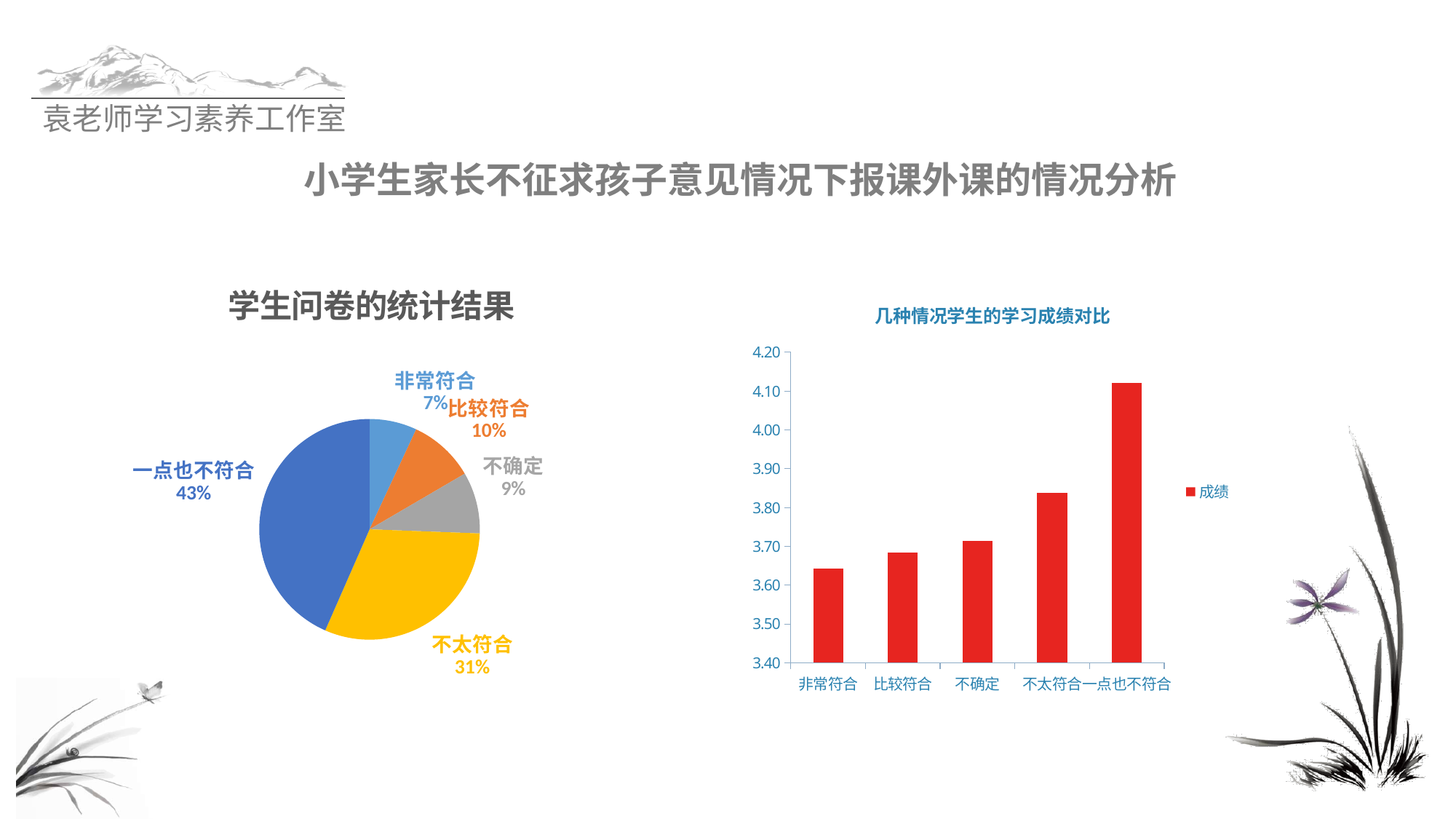
In the pie chart 学生问卷的统计结果, what is the difference in percentage points between 一点也不符合 and 不太符合? 12 In the pie chart 学生问卷的统计结果, what percentage is shown for 非常符合? 7% In the bar chart 几种情况学生的学习成绩对比, is the value for 一点也不符合 greater or less than 4.00? greater In the pie chart 学生问卷的统计结果, what percentage is shown for 一点也不符合? 43% In the pie chart 学生问卷的统计结果, what percentage is shown for 不太符合? 31% In the bar chart 几种情况学生的学习成绩对比, do the values rise or fall from 非常符合 to 一点也不符合? rise What kind of chart is 几种情况学生的学习成绩对比? bar chart In the pie chart 学生问卷的统计结果, which category has the smallest share? 非常符合 In the pie chart 学生问卷的统计结果, which category has the largest share? 一点也不符合 How many series does the legend of the bar chart 几种情况学生的学习成绩对比 list? 1 How many slices does the pie chart 学生问卷的统计结果 have? 5 In the pie chart 学生问卷的统计结果, which is larger, 比较符合 or 不确定? 比较符合